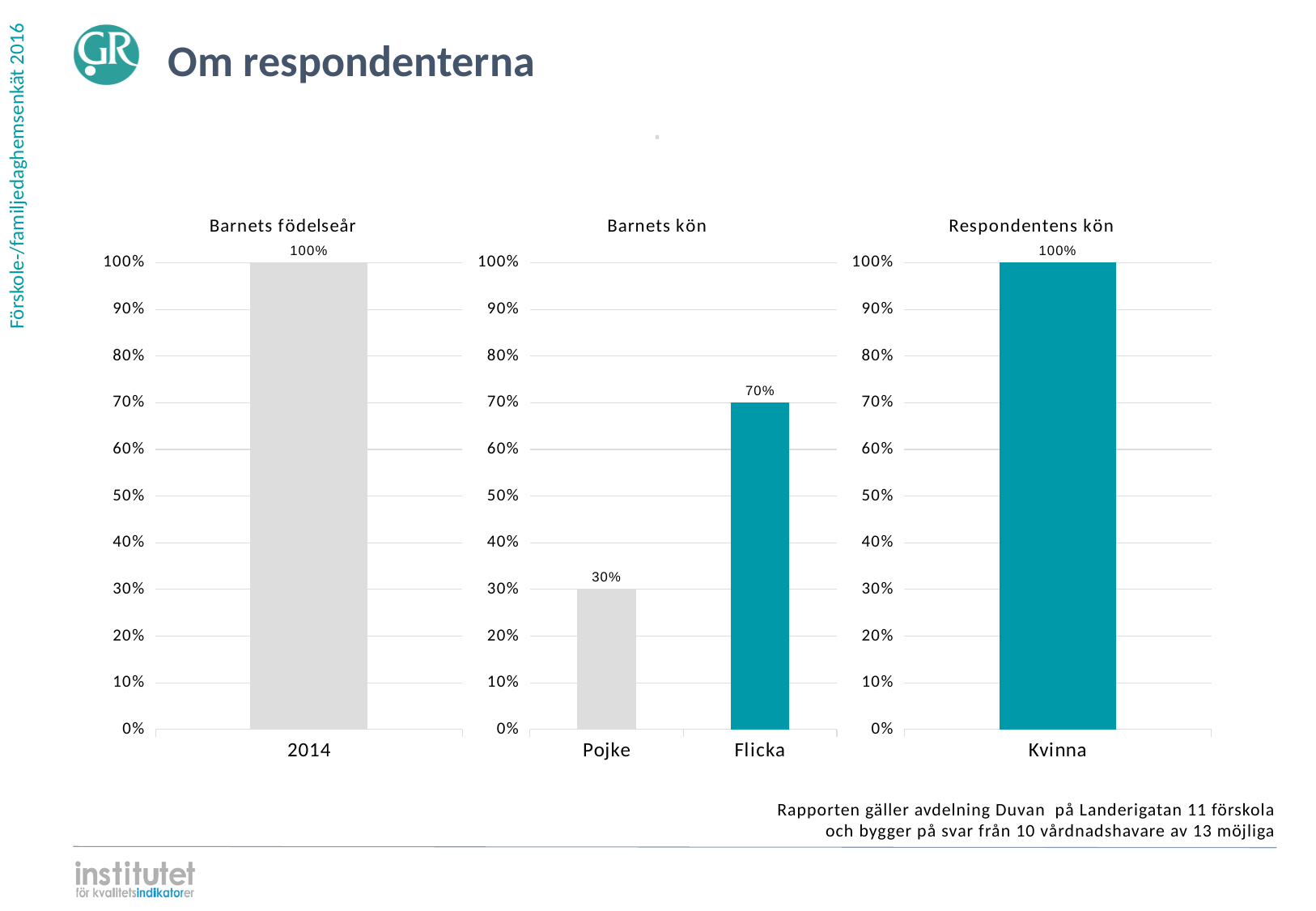
In the 'Barnets kön' chart, is the value for Pojke greater or less than 50%? less In the 'Barnets kön' chart, which category has the highest value? Flicka In the 'Barnets kön' chart, what is the difference between the values for Flicka and Pojke? 40% In the 'Barnets kön' chart, what is the value for Pojke? 30% In the 'Barnets kön' chart, which is larger, Pojke or Flicka? Flicka In the 'Barnets födelseår' chart, what is the value for 2014? 100% What kind of chart is the 'Respondentens kön' chart? bar chart In the 'Barnets kön' chart, which category has the lowest value? Pojke In the 'Barnets kön' chart, what is the value for Flicka? 70% What is the title of the leftmost chart on the slide? Barnets födelseår How many categories are shown in the 'Barnets kön' chart? 2 In the 'Respondentens kön' chart, what is the value for Kvinna? 100%